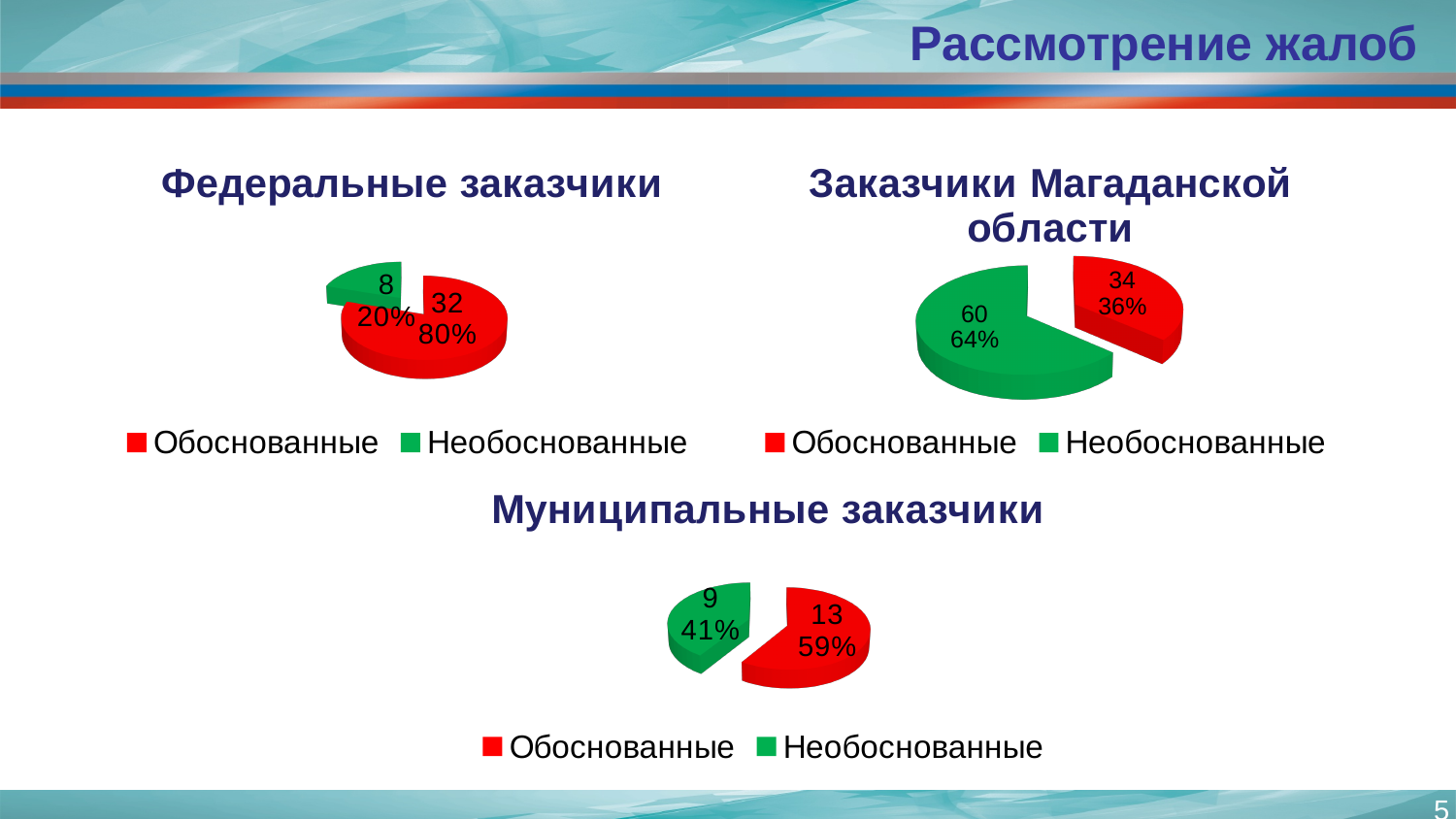
In the 'Федеральные заказчики' chart, which category is the largest? Обоснованные In the 'Заказчики Магаданской области' chart, what is the value for 'Необоснованные'? 60 In the 'Муниципальные заказчики' chart, what is the value for 'Обоснованные'? 13 What type of chart is the 'Муниципальные заказчики' chart? Pie chart In the 'Федеральные заказчики' chart, what share of the pie is 'Необоснованные'? 20% In the 'Заказчики Магаданской области' chart, what share of the pie is 'Обоснованные'? 36% How many entries does the legend of the 'Федеральные заказчики' chart list? 2 In the 'Муниципальные заказчики' chart, what share of the pie is 'Необоснованные'? 41% In the 'Заказчики Магаданской области' chart, which category is the smallest? Обоснованные In the 'Федеральные заказчики' chart, how many complaints are 'Обоснованные'? 32 In the 'Муниципальные заказчики' chart, what is the difference between 'Обоснованные' and 'Необоснованные'? 4 In the 'Заказчики Магаданской области' chart, which is larger: 'Обоснованные' or 'Необоснованные'? Необоснованные